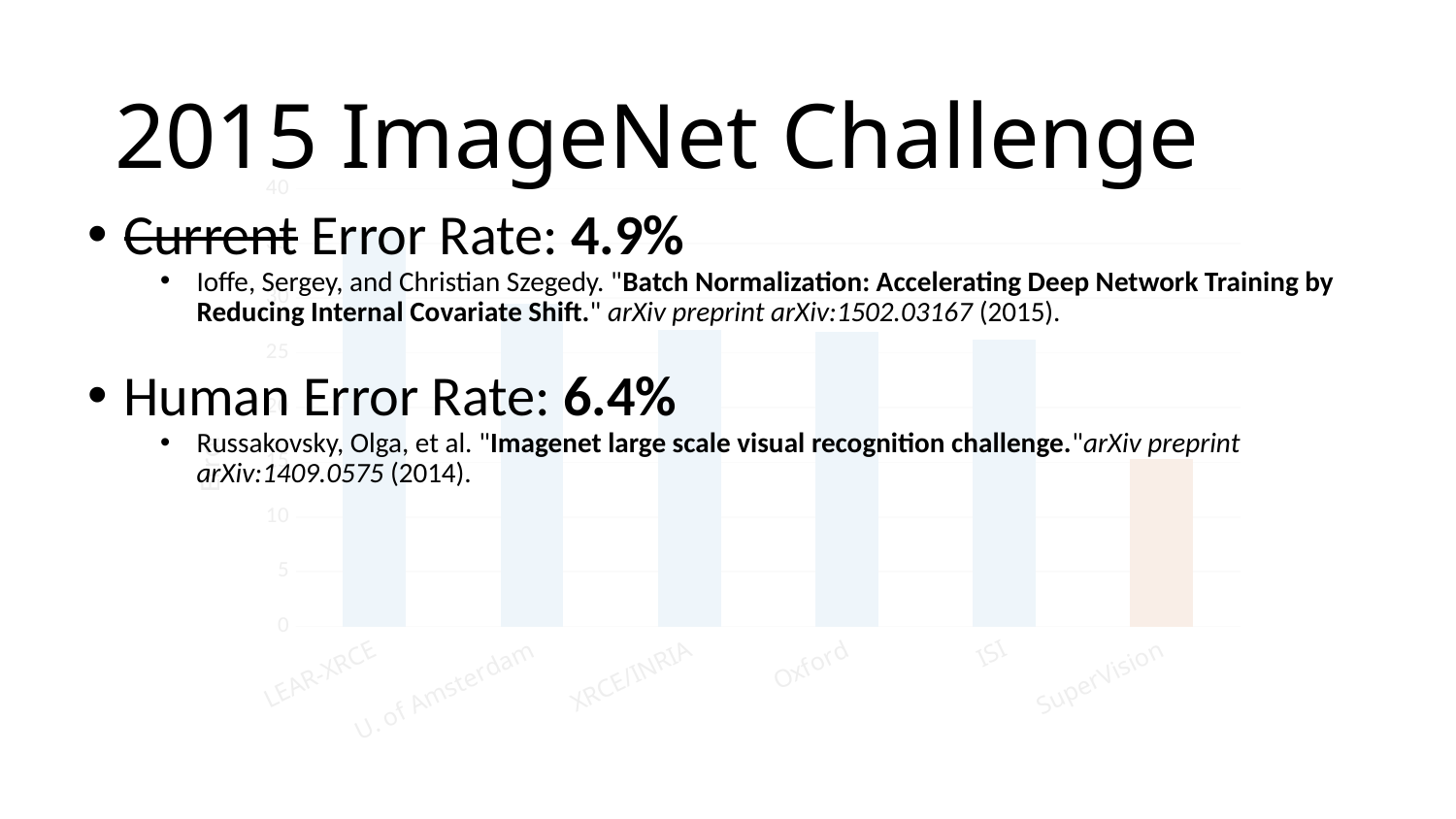
Do the bar values generally rise or fall from left to right along the x axis? fall Is the value for U. of Amsterdam greater or less than 25? greater What kind of chart is shown on the slide? bar chart Is the value for LEAR-XRCE greater or less than 40? less How many categories are plotted on the chart? 6 Is the value for LEAR-XRCE greater or less than 25? greater Which category has the lowest bar? SuperVision Which category has the highest bar? LEAR-XRCE Which category's bar is shown in a different colour from the others? SuperVision Which is larger, the value for LEAR-XRCE or the value for SuperVision? LEAR-XRCE